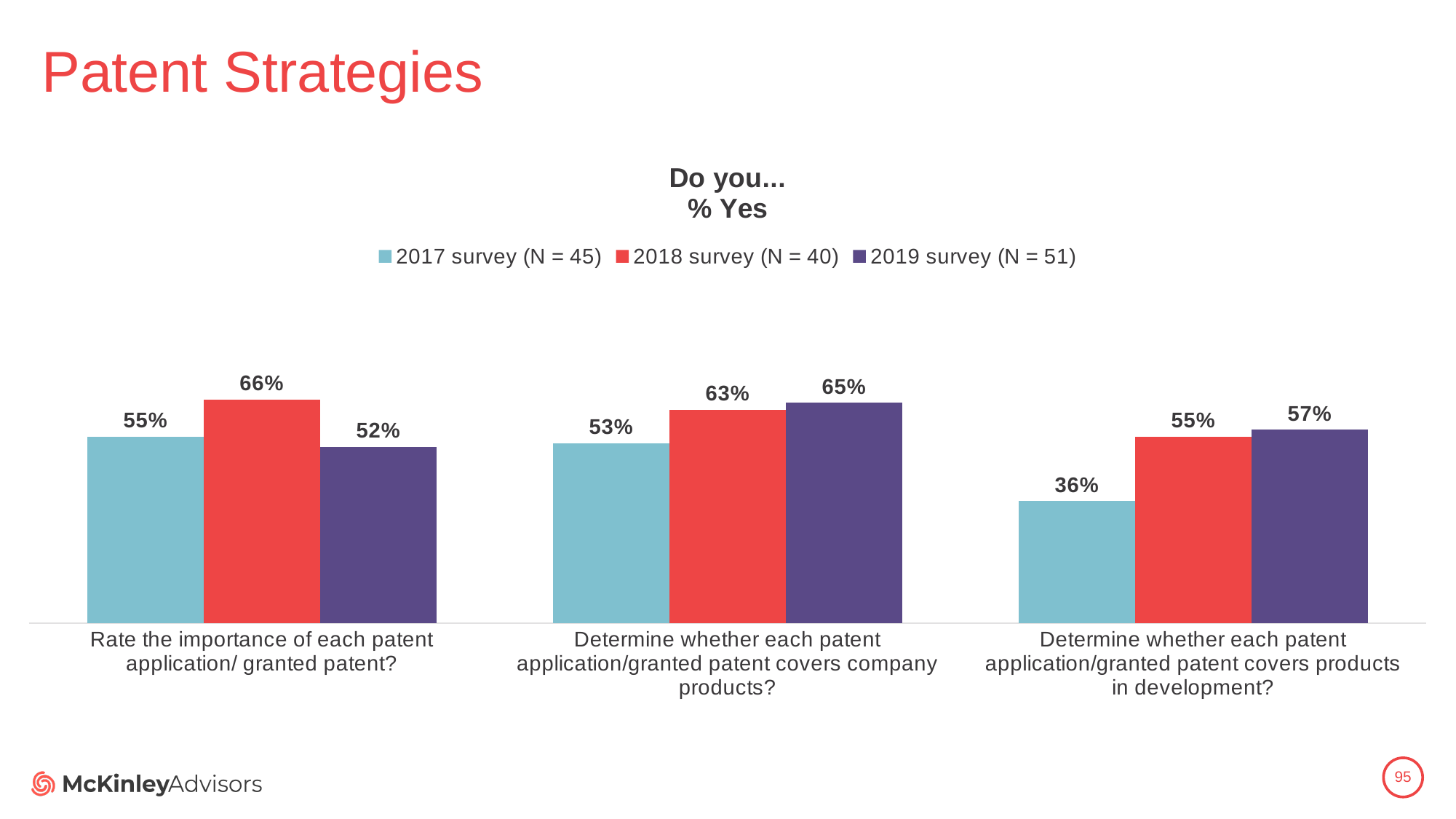
Which survey year has the highest value for rating the importance of each patent application/granted patent? 2018 survey (N = 40) What percentage of respondents in the 2018 survey said they rate the importance of each patent application/granted patent? 66% What is the 2019 survey value for determining whether each patent application/granted patent covers company products? 65% Which survey year has the lowest value for determining whether each patent application/granted patent covers products in development? 2017 survey (N = 45) What is the 2017 survey value for determining whether each patent application/granted patent covers products in development? 36% What is the sample size (N) of the 2019 survey according to the legend? 51 What is the title of the chart? Do you... % Yes How many series does the legend list? 3 What kind of chart is shown on the slide? Bar chart How many question categories are shown on the x axis? 3 What is the difference between the 2019 and 2017 survey values for determining whether each patent application/granted patent covers products in development? 21 percentage points Which is larger for rating the importance of each patent application/granted patent: the 2017 survey value or the 2019 survey value? 2017 survey